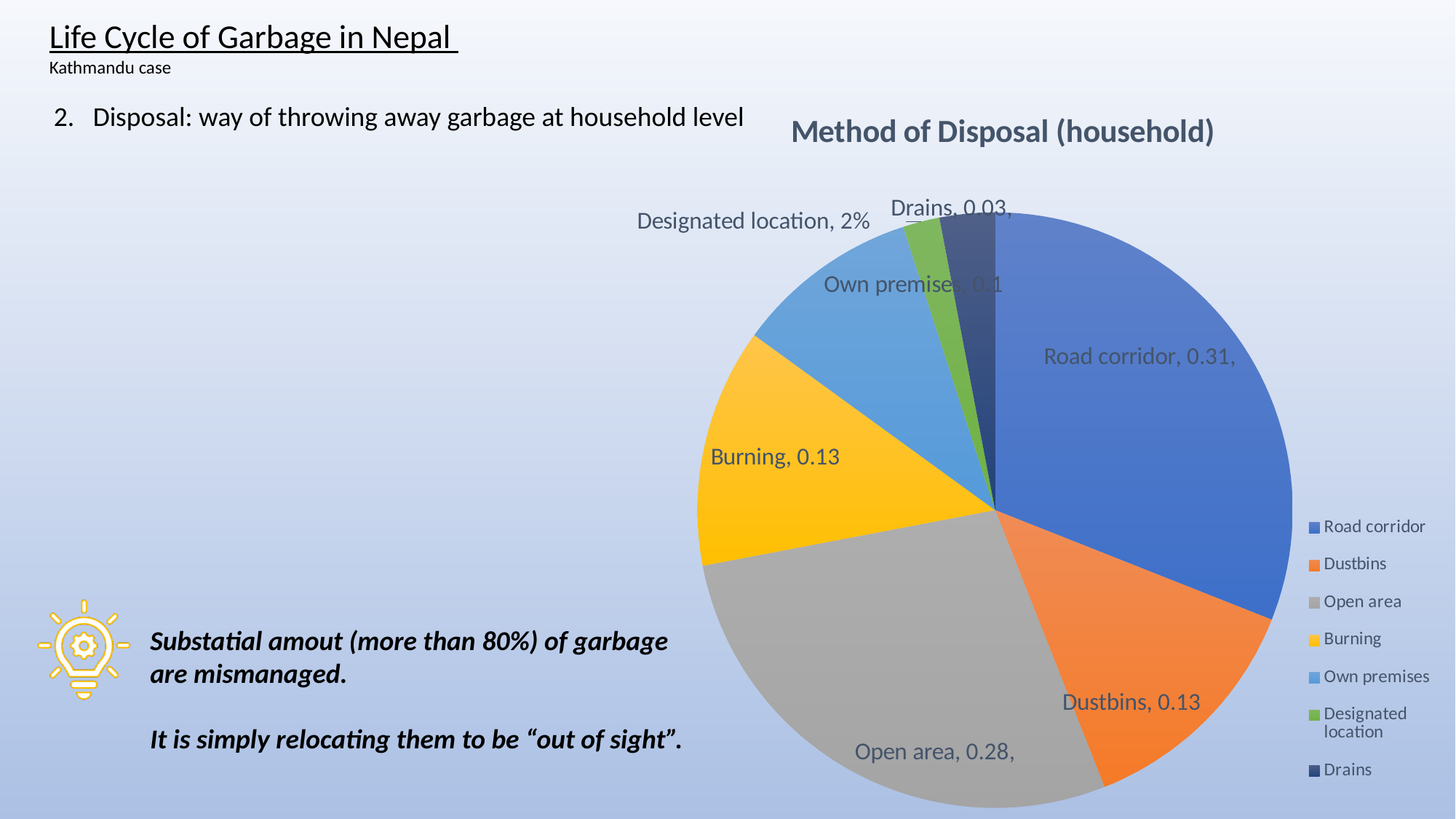
What value is shown for Own premises in the pie chart? 0.1 Which is larger, the slice for Road corridor or the slice for Open area? Road corridor Which disposal method has the largest slice of the pie? Road corridor What is the title of the chart? Method of Disposal (household) What value is shown for Open area in the pie chart? 0.28 What value is shown for Designated location in the pie chart? 2% Which disposal method has the smallest slice of the pie? Designated location What is the difference between the values for Road corridor and Open area? 0.03 What kind of chart is shown on the slide? pie chart How many disposal methods does the legend list? 7 What value is shown for Road corridor in the pie chart? 0.31 What value is shown for Drains in the pie chart? 0.03